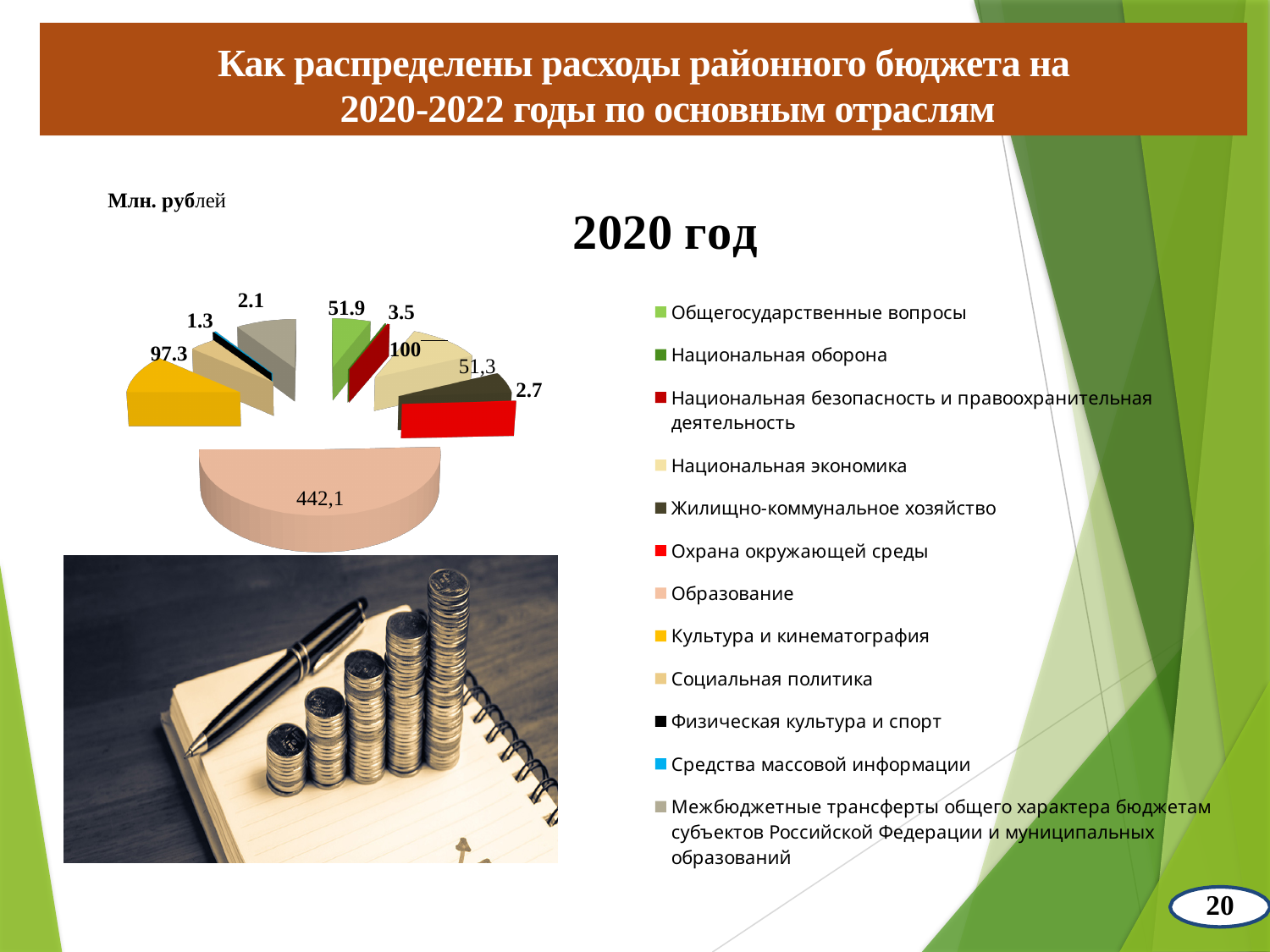
What is the value for Общегосударственные вопросы on the pie chart? 51.9 Which is larger on the pie chart: Образование or Культура и кинематография? Образование What is the value for Культура и кинематография on the pie chart? 97.3 Which category has the largest slice of the pie chart? Образование What is the value for Образование on the pie chart? 442,1 In what units are the values on the pie chart given? Млн. рублей What is the smallest value printed on the pie chart? 1.3 How many categories does the legend of the pie chart list? 12 What is the value of the largest slice of the pie chart? 442,1 What year does the pie chart on the slide represent? 2020 год What kind of chart is shown on the slide? pie chart What is the difference between the values for Образование and Культура и кинематография on the pie chart? 344.8